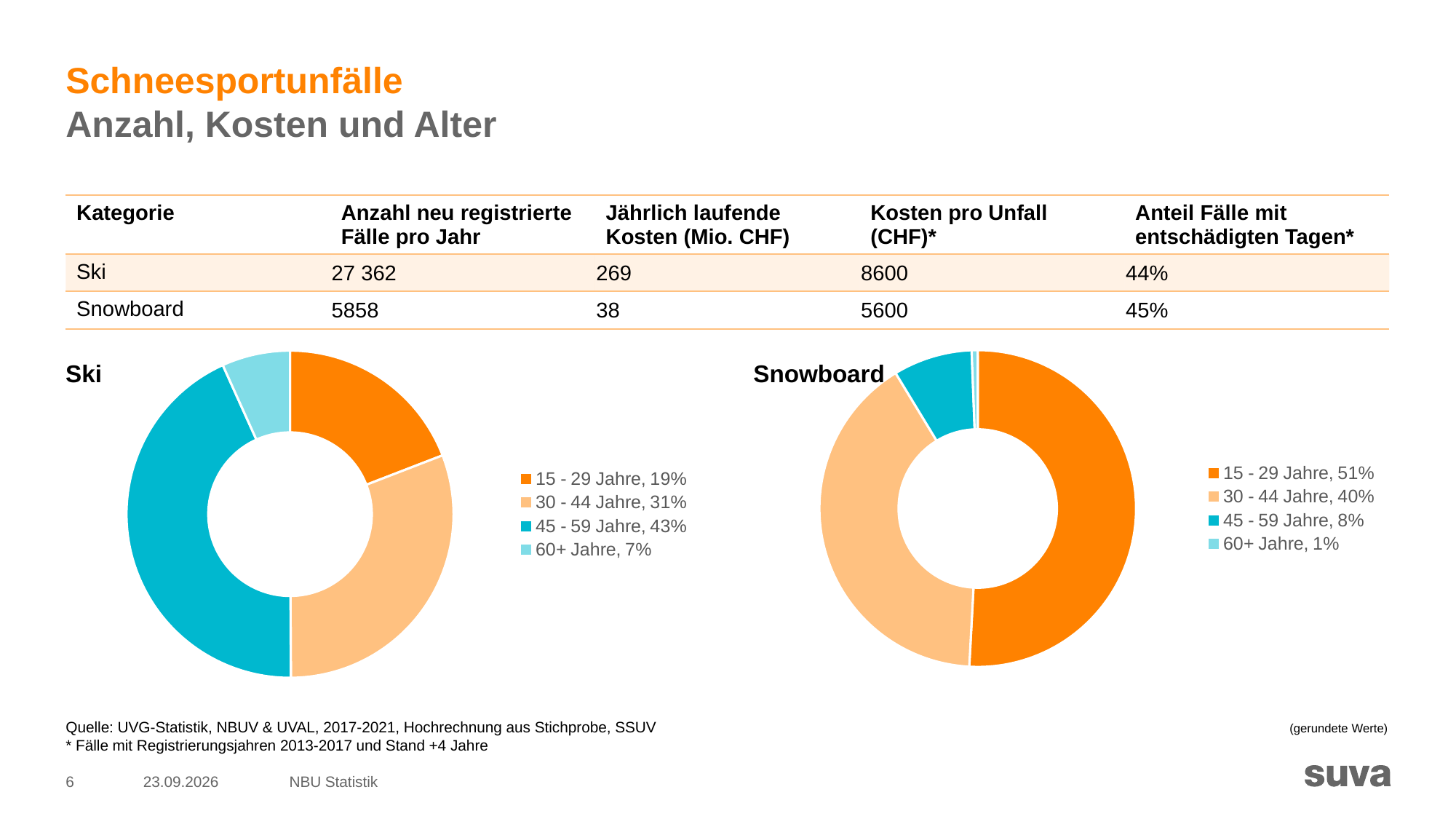
What type of chart is the Snowboard chart? Doughnut chart In the Snowboard chart, what share of cases is in the 15 - 29 Jahre age group? 51% In the Snowboard chart, what share of cases is in the 60+ Jahre age group? 1% In the Ski chart, what colour represents the 15 - 29 Jahre group? Orange In the Ski chart, which is larger: the share of 30 - 44 Jahre or 60+ Jahre? 30 - 44 Jahre In the Snowboard chart, what is the difference between the shares of the 15 - 29 Jahre and 30 - 44 Jahre groups? 11% In the Ski chart, what is the difference between the shares of the 45 - 59 Jahre and 15 - 29 Jahre groups? 24% In the Ski chart, what share of cases is in the 45 - 59 Jahre age group? 43% In the Ski chart, which age group has the largest share? 45 - 59 Jahre How many age groups does the Ski chart show? 4 Which chart has the larger share for the 30 - 44 Jahre group, Ski or Snowboard? Snowboard In the Snowboard chart, which age group has the smallest share? 60+ Jahre